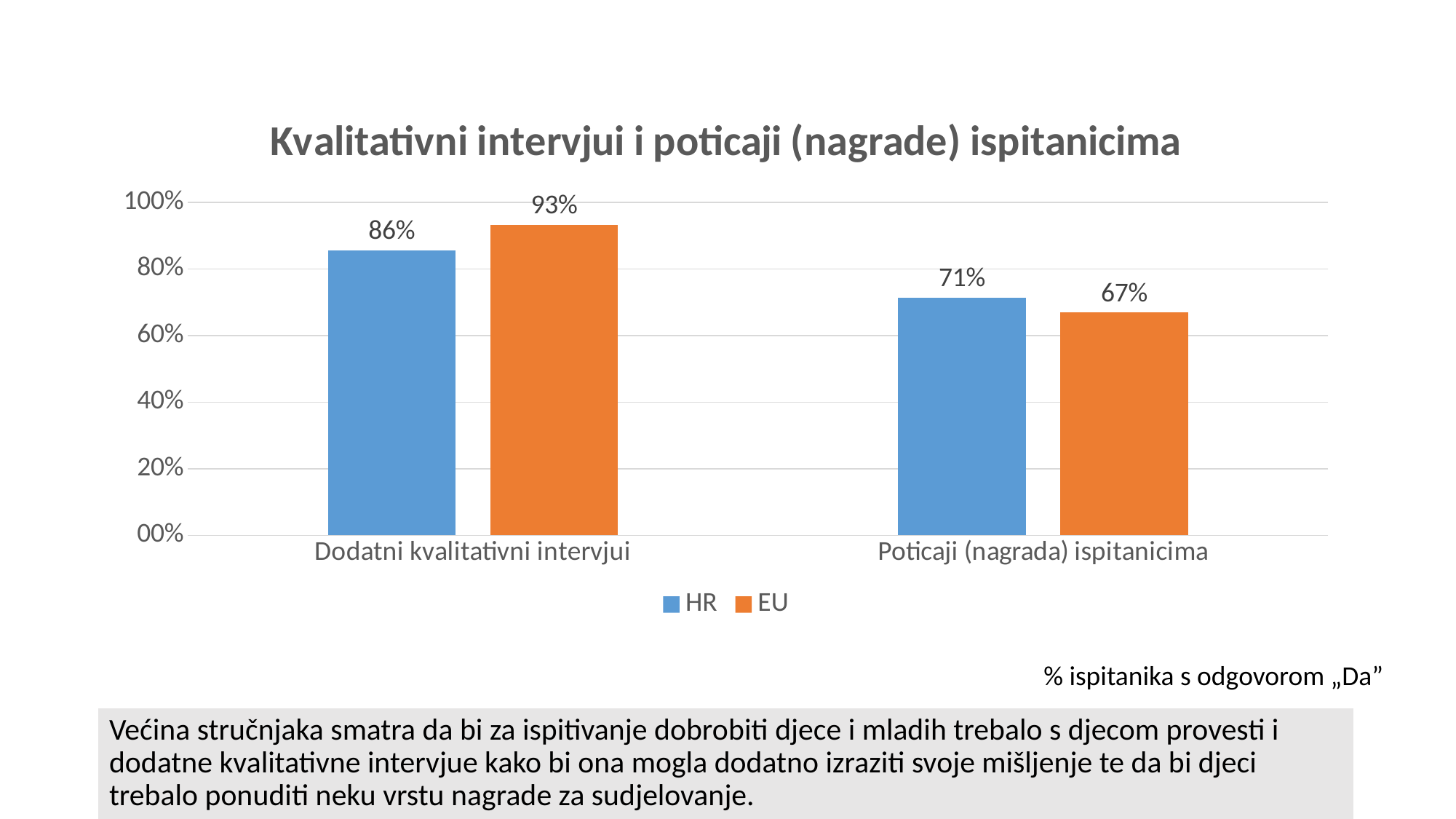
What kind of chart is shown on the slide? Bar chart What is the difference between the EU and HR values for Dodatni kvalitativni intervjui? 7% How many categories are shown on the x axis? 2 How many series does the legend list? 2 What is the EU value for Poticaji (nagrada) ispitanicima? 67% Which series has the lowest value for Poticaji (nagrada) ispitanicima? EU What is the HR value for Poticaji (nagrada) ispitanicima? 71% What is the EU value for Dodatni kvalitativni intervjui? 93% What is the HR value for Dodatni kvalitativni intervjui? 86% Which is larger: the HR value for Dodatni kvalitativni intervjui or the HR value for Poticaji (nagrada) ispitanicima? Dodatni kvalitativni intervjui Which series has the highest value for Dodatni kvalitativni intervjui? EU What is the difference between the HR and EU values for Poticaji (nagrada) ispitanicima? 4%